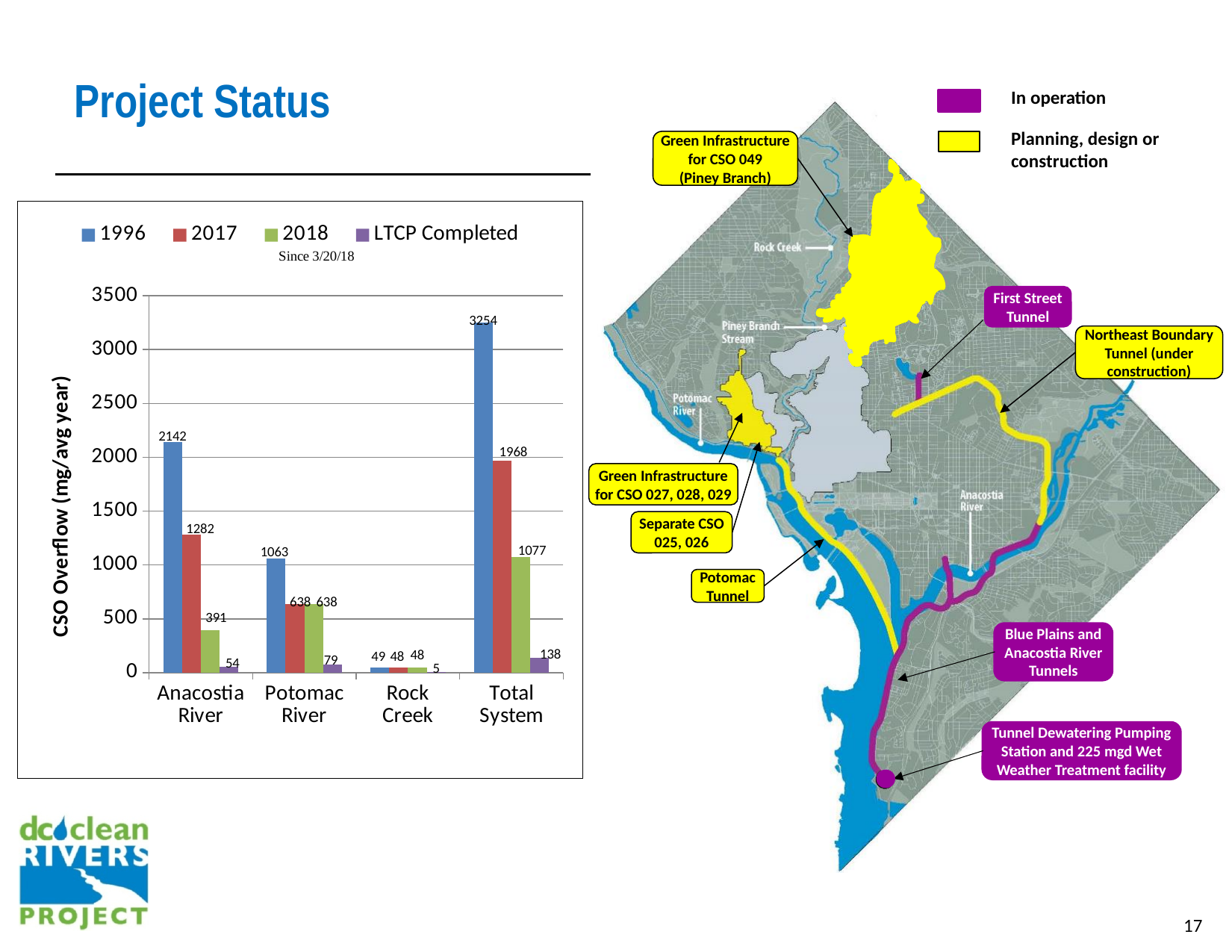
What kind of chart is shown on the slide? bar chart Which category has the lowest LTCP Completed value? Rock Creek Is the 2018 value for the Total System greater or less than 1000? greater Which is larger for the Anacostia River: the 2017 value or the 2018 value? 2017 What is the difference between the 1996 and 2017 values for the Total System? 1286 What is the 2018 CSO overflow value for the Potomac River? 638 Which category has the highest 1996 value? Total System How many categories are shown on the x axis? 4 How many series does the legend list? 4 What is the 2017 value for Rock Creek? 48 What is the 1996 CSO overflow value for the Anacostia River? 2142 What is the LTCP Completed value for the Total System? 138